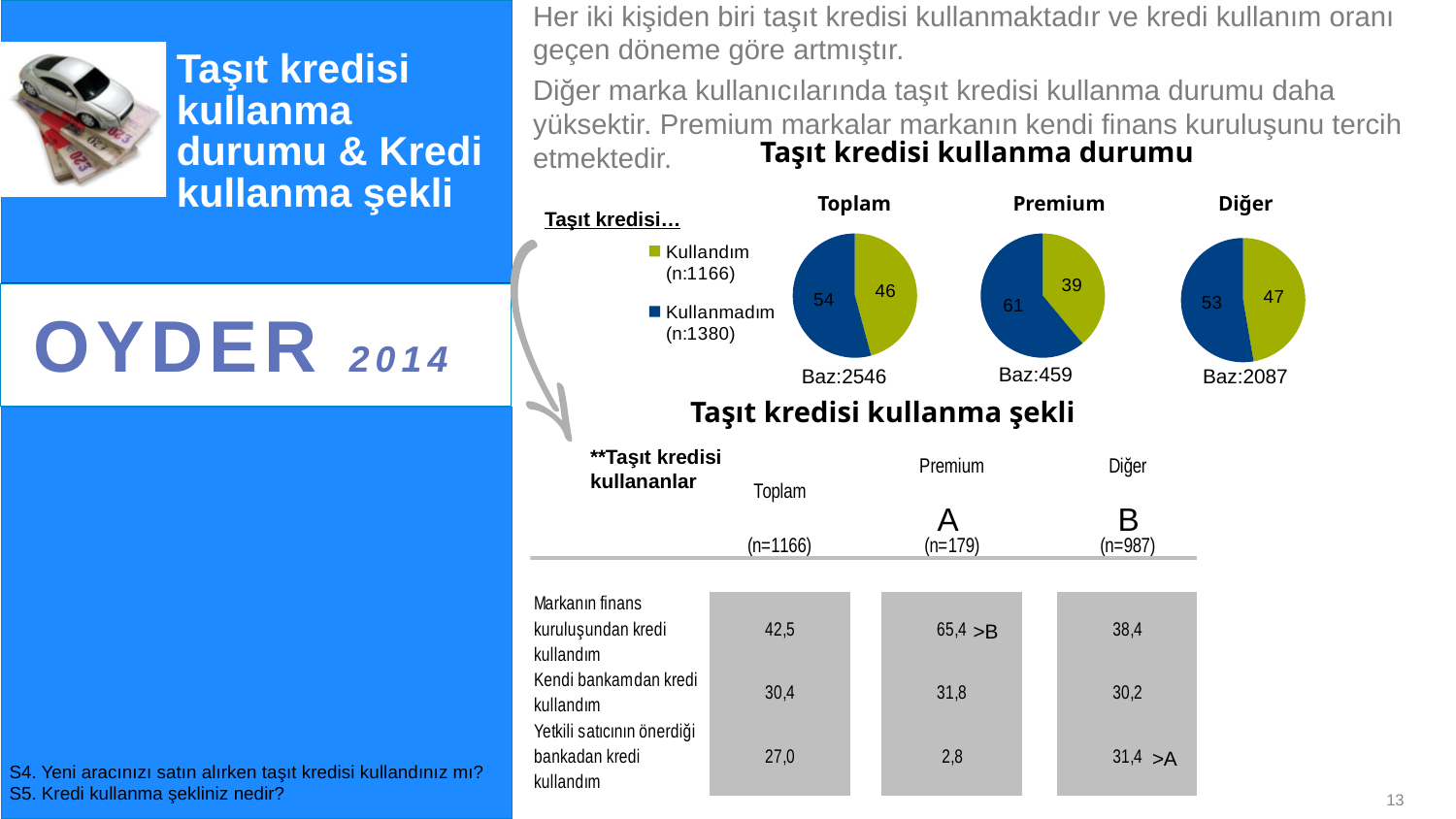
In the Premium pie chart, what is the value for Kullanmadım? 61 What is the Baz value shown under the Premium pie chart? Baz:459 Across the three pie charts (Toplam, Premium, Diğer), which one has the highest Kullandım value? Diğer In the Toplam pie chart, what is the value for Kullandım? 46 In the Premium pie chart, what is the value for Kullandım? 39 What type of charts are used under the title 'Taşıt kredisi kullanma durumu'? Pie charts In the Diğer pie chart, what is the value for Kullanmadım? 53 In the Premium pie chart, which slice is larger, Kullandım or Kullanmadım? Kullanmadım In the Diğer pie chart, what is the value for Kullandım? 47 In the Premium pie chart, what is the difference between Kullanmadım and Kullandım? 22 In the Toplam pie chart, what is the value for Kullanmadım? 54 How many series does the legend of the pie charts list? 2